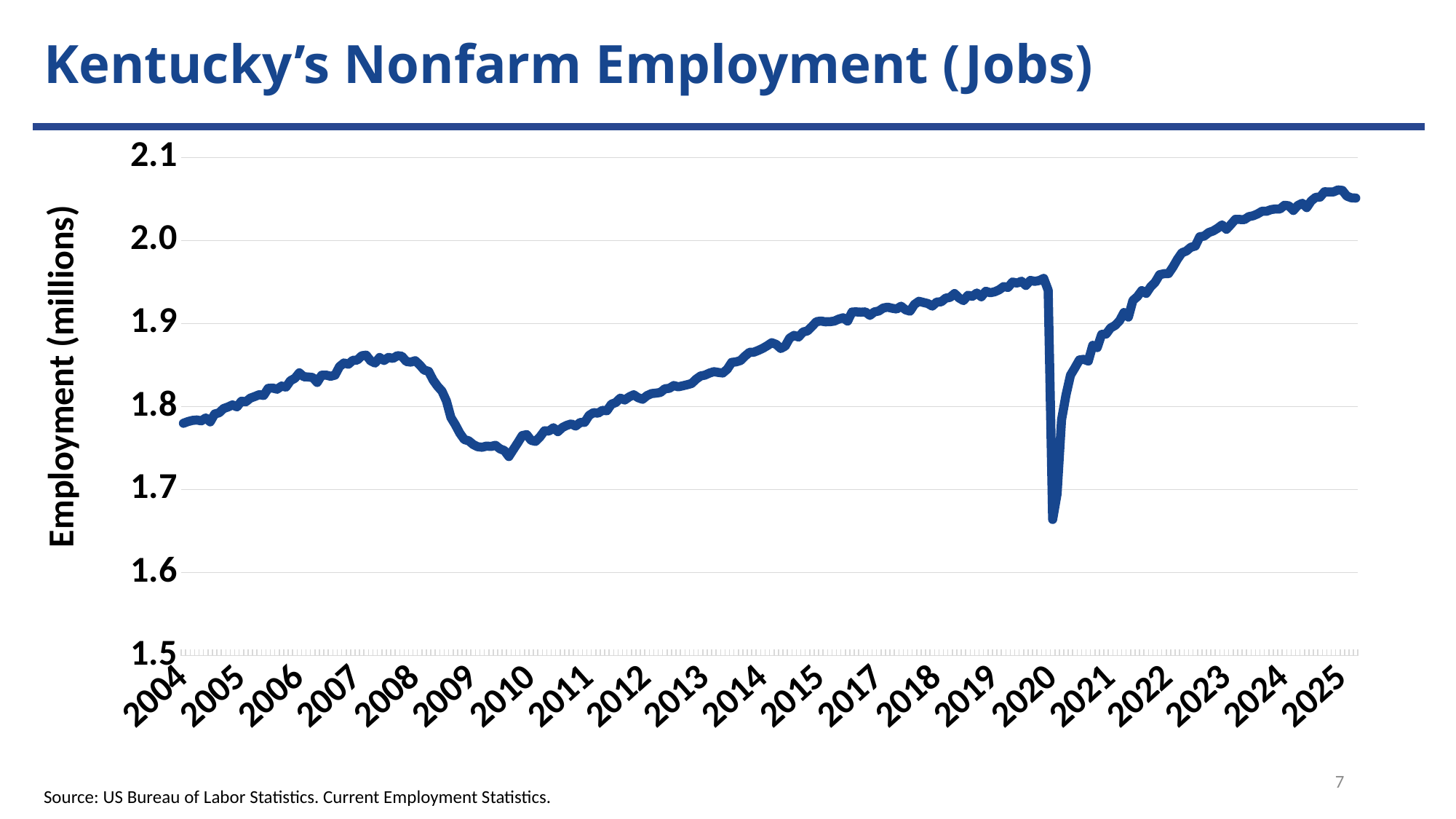
What kind of chart is shown on the slide? line chart What is the label on the vertical axis of the chart? Employment (millions) In which year does the line reach its highest point? 2025 Is the value just before the 2020 drop greater or less than 1.9? greater Is the value at the low point around 2010 greater or less than 1.8? less Is the value in 2019 larger or smaller than the value in 2004? larger Is the value at the sharp dip in 2020 greater or less than 1.7? less Does the line rise or fall between 2008 and 2010? fall In which year does the line reach its lowest point? 2020 What is the title of the chart? Kentucky's Nonfarm Employment (Jobs) Does the line rise or fall between 2021 and 2025? rise